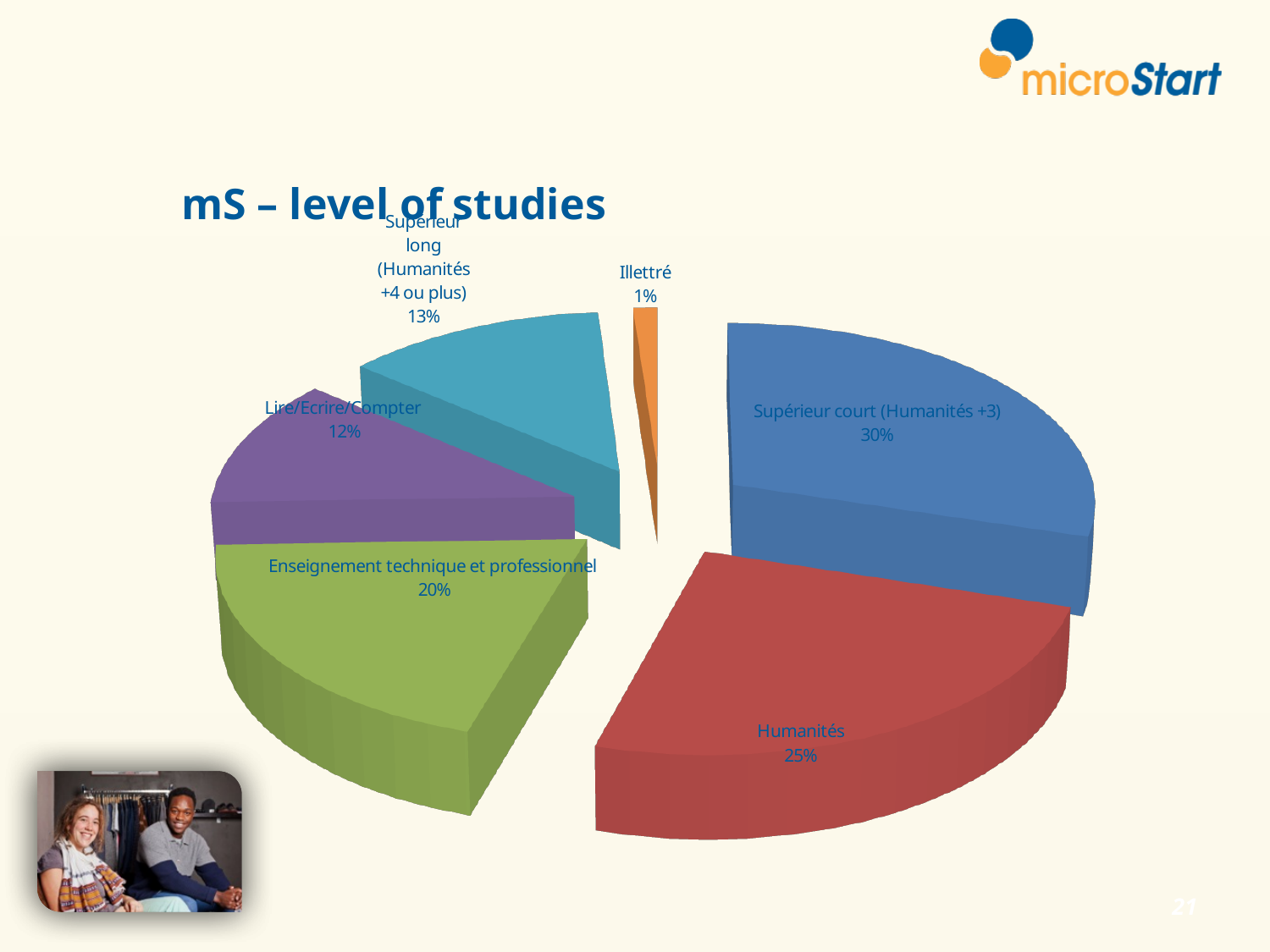
What is the value for Humanités? 25% Which is larger, the share for Enseignement technique et professionnel or the share for Lire/Ecrire/Compter? Enseignement technique et professionnel What share of the pie does Supérieur court (Humanités +3) represent? 30% What kind of chart is shown on the slide? pie chart How many categories are shown in the pie chart? 6 What is the value for Enseignement technique et professionnel? 20% Which category has the largest share of the pie? Supérieur court (Humanités +3) What is the value for Lire/Ecrire/Compter? 12% Which category has the smallest share of the pie? Illettré What is the value for Illettré? 1% What is the difference between the shares for Supérieur court (Humanités +3) and Humanités? 5% What is the value for Supérieur long (Humanités +4 ou plus)? 13%